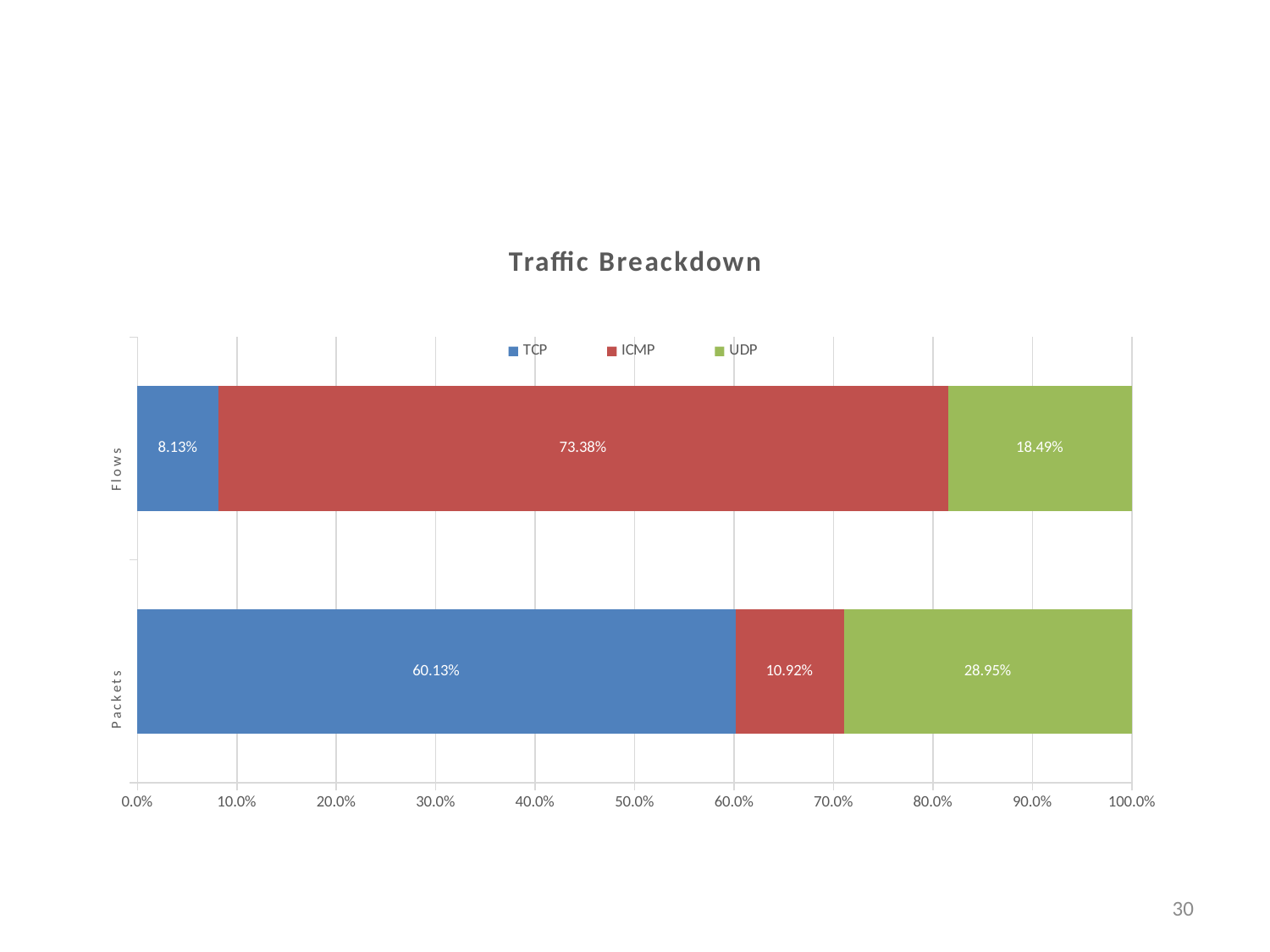
Which protocol has the smallest share of Packets? ICMP Which protocol has the largest share of Flows? ICMP What is the TCP share of Flows? 8.13% What is the UDP share of Flows? 18.49% How many categories are shown on the vertical axis? 2 What type of chart is shown? Stacked bar chart What is the difference between the UDP share of Packets and the UDP share of Flows? 10.46% What is the ICMP share of Packets? 10.92% Which is larger: the ICMP share of Flows or the ICMP share of Packets? ICMP share of Flows How many series does the legend list? 3 What is the TCP share of Packets? 60.13% Is the TCP share of Packets greater or less than 50.0%? greater